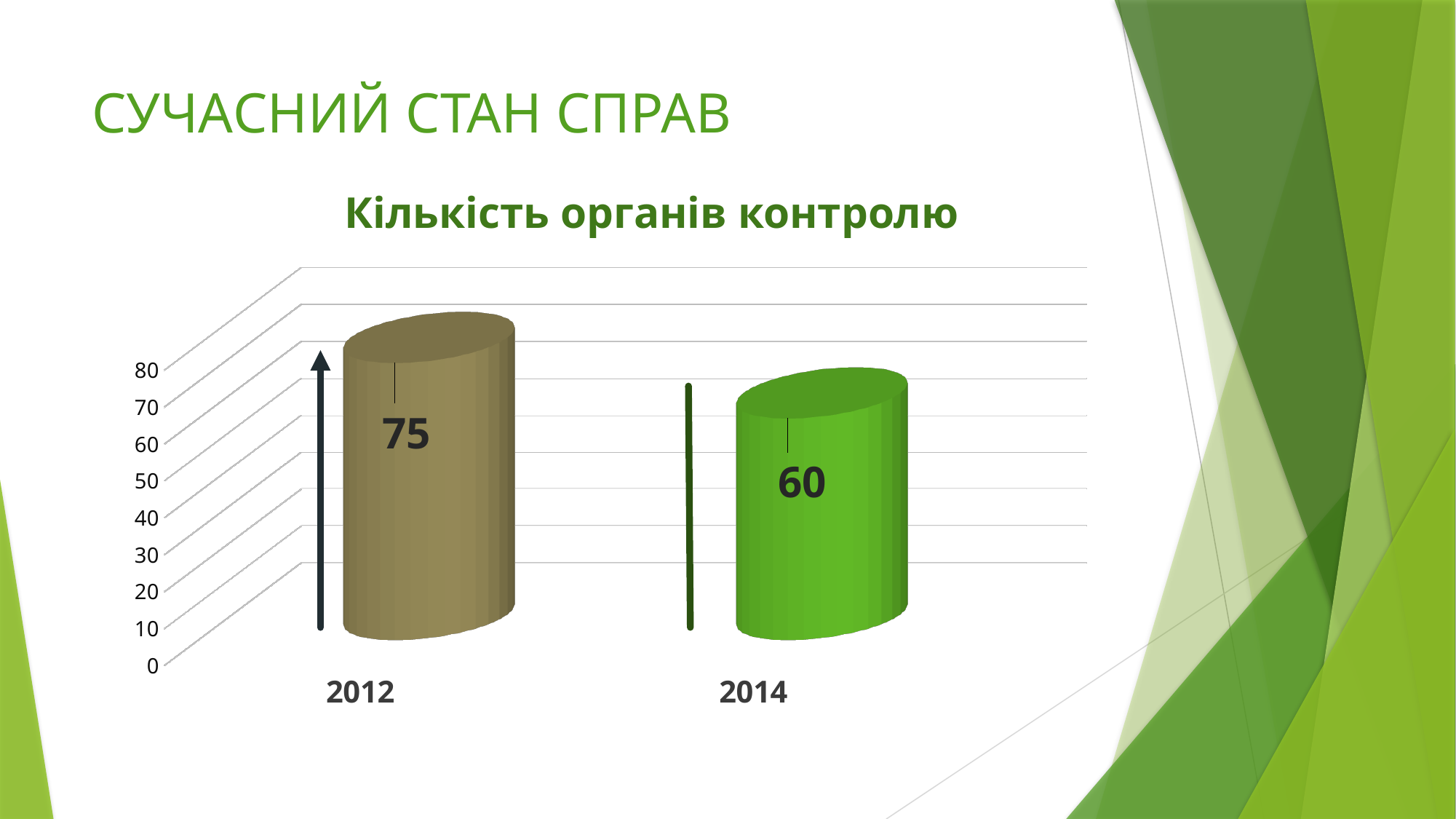
Which year has the highest value? 2012 Do the values rise or fall from 2012 to 2014? fall What is the highest tick value shown on the vertical axis? 80 What kind of chart is shown on the slide? bar chart How many categories are shown on the x axis? 2 What is the title of the chart? Кількість органів контролю Which year has the lowest value? 2014 What is the difference between the values for 2012 and 2014? 15 Which is larger, the value for 2012 or the value for 2014? 2012 Is the value for 2014 greater or less than 70? less What is the value for 2012? 75 What is the value for 2014? 60